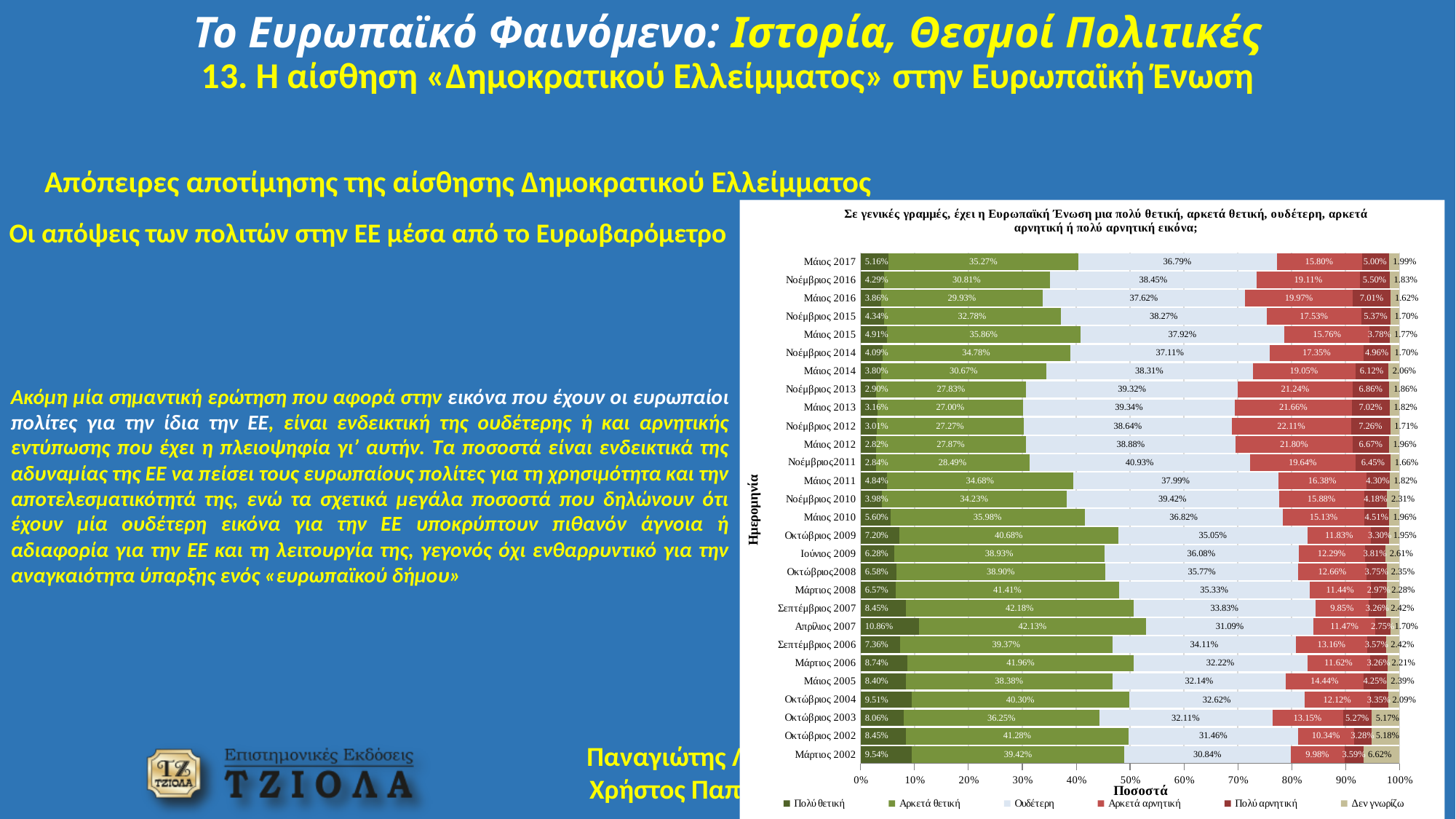
What is the value of Δεν γνωρίζω for Μάρτιος 2002? 6.62% What is the difference between the Αρκετά θετική values for Μάιος 2017 and Νοέμβριος 2016? 4.46 percentage points Which has the larger Αρκετά αρνητική value, Μάιος 2016 or Μάιος 2014? Μάιος 2016 What is the value of Αρκετά αρνητική for Νοέμβριος 2012? 22.11% Which date has the lowest value for Ουδέτερη? Μάρτιος 2002 What is the value of Πολύ θετική for Απρίλιος 2007? 10.86% Which date has the highest value for Πολύ θετική? Απρίλιος 2007 What is the value of Ουδέτερη for Μάιος 2017? 36.79% Which date has the highest value for Ουδέτερη? Νοέμβριος 2011 How many series does the chart legend list? 6 How many dates (categories) are plotted on the chart? 28 What type of chart is shown on the slide? Stacked bar chart